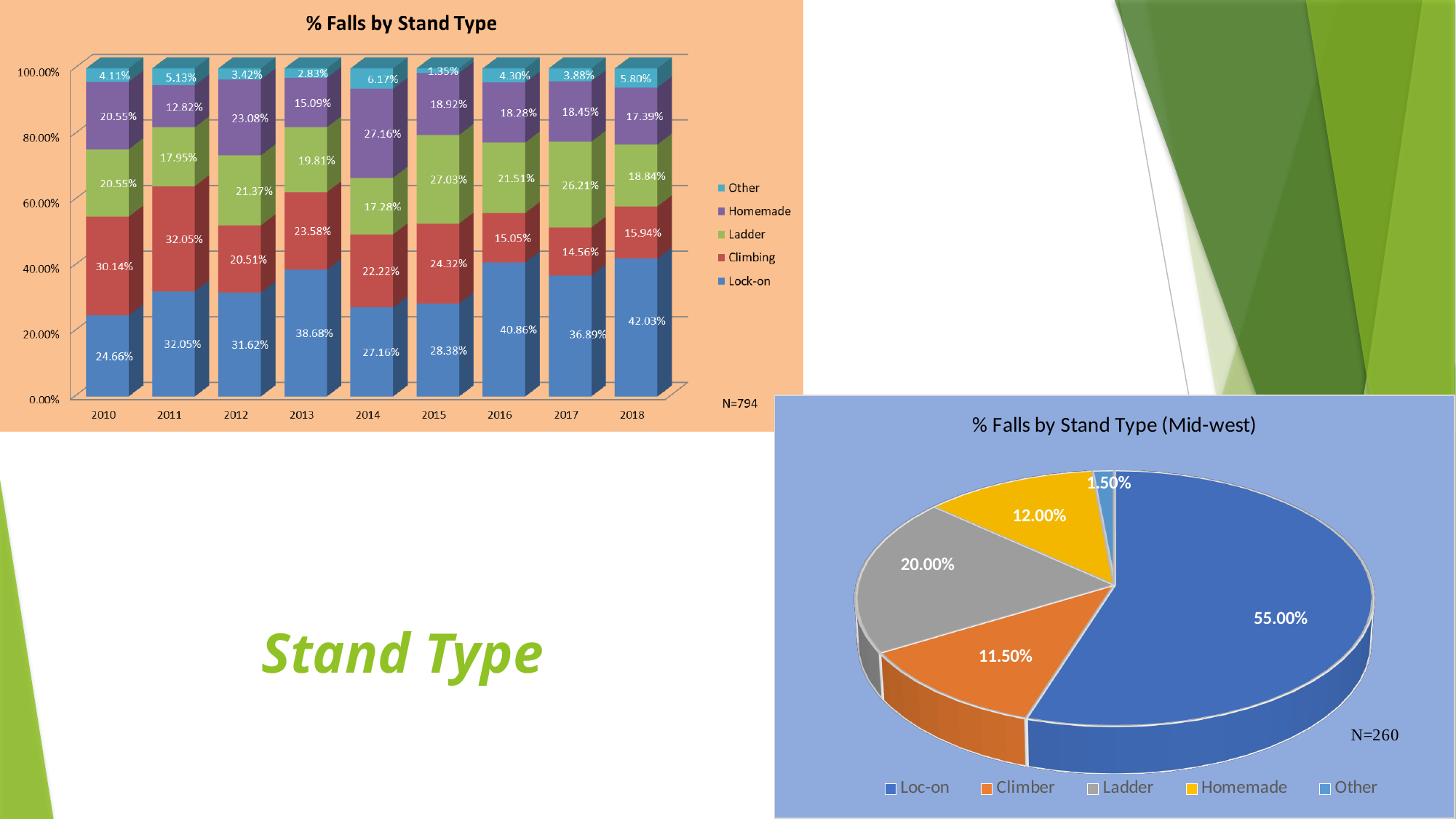
In the '% Falls by Stand Type' bar chart, what is the difference between the Ladder values for 2015 and 2014? 9.75% In the '% Falls by Stand Type' bar chart, what is the Homemade value for 2014? 27.16% In the '% Falls by Stand Type' bar chart, which year has the highest Lock-on value? 2018 In the '% Falls by Stand Type (Mid-west)' pie chart, which category has the largest slice? Loc-on What kind of chart is '% Falls by Stand Type (Mid-west)'? Pie chart In the '% Falls by Stand Type' bar chart, what is the Climbing value for 2011? 32.05% In the '% Falls by Stand Type' bar chart, what is the Lock-on value for 2018? 42.03% In the '% Falls by Stand Type (Mid-west)' pie chart, what share does Ladder have? 20.00% In the '% Falls by Stand Type' bar chart, which year has the lowest Other value? 2015 How many series does the legend of the '% Falls by Stand Type' bar chart list? 5 How many years are shown on the x axis of the '% Falls by Stand Type' bar chart? 9 In the '% Falls by Stand Type' bar chart, which is larger: the Climbing value for 2013 or the Climbing value for 2016? 2013